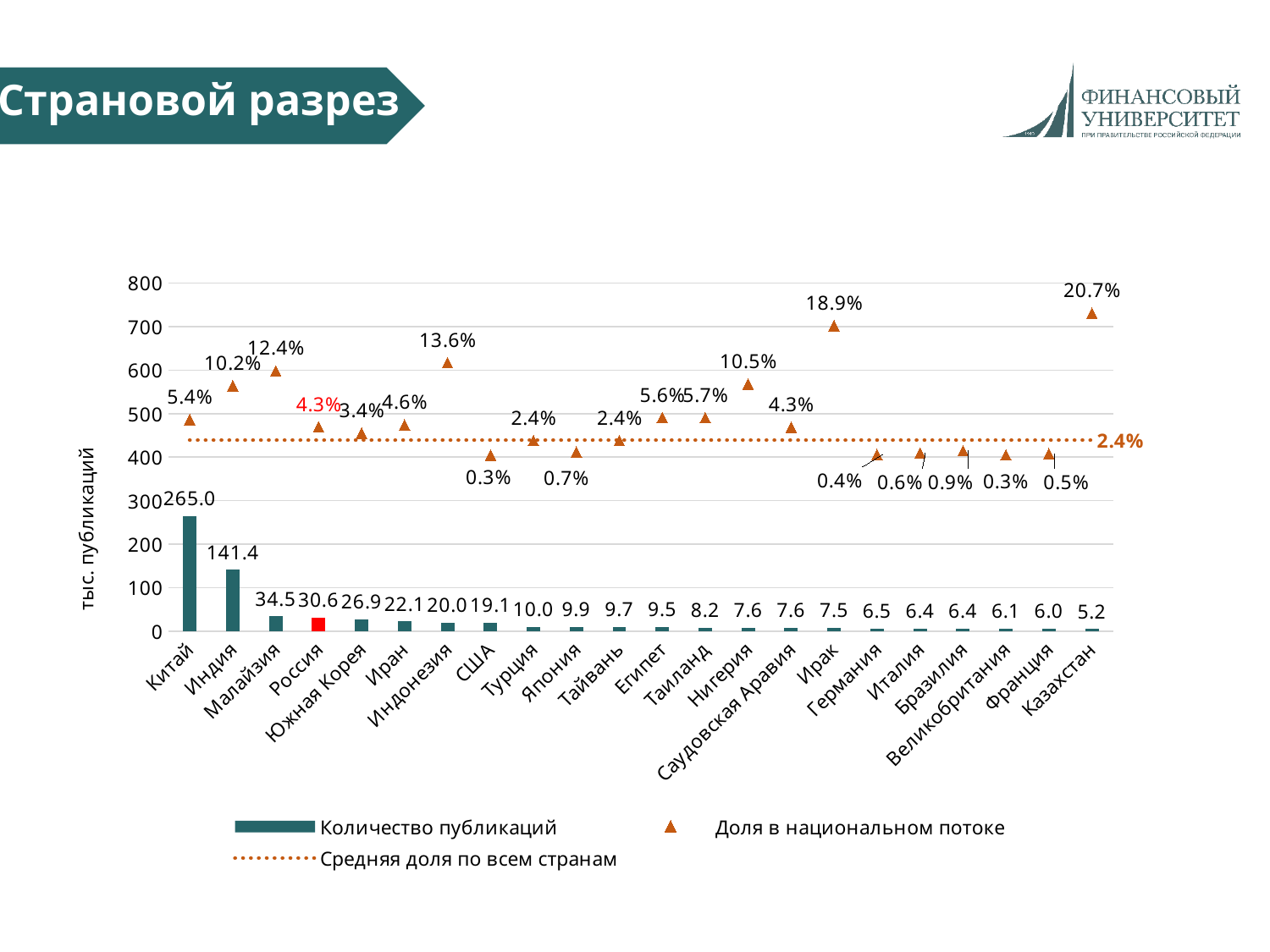
What is the difference in number of publications between Китай and Индия? 123.6 How many series does the legend list? 3 What value does the dotted line for the average share across all countries (Средняя доля по всем странам) show? 2.4% What is the share in the national flow (Доля в национальном потоке) for Казахстан? 20.7% How many countries are shown on the x axis? 22 Do the bar values for number of publications rise or fall from left to right along the x axis? fall Which country has the lowest number of publications? Казахстан Which country has the highest share in the national flow? Казахстан Which has a larger share in the national flow, Ирак or Нигерия? Ирак What is the number of publications (Количество публикаций) for Китай? 265.0 What is the number of publications for Россия? 30.6 What is the y-axis label of the chart? тыс. публикаций